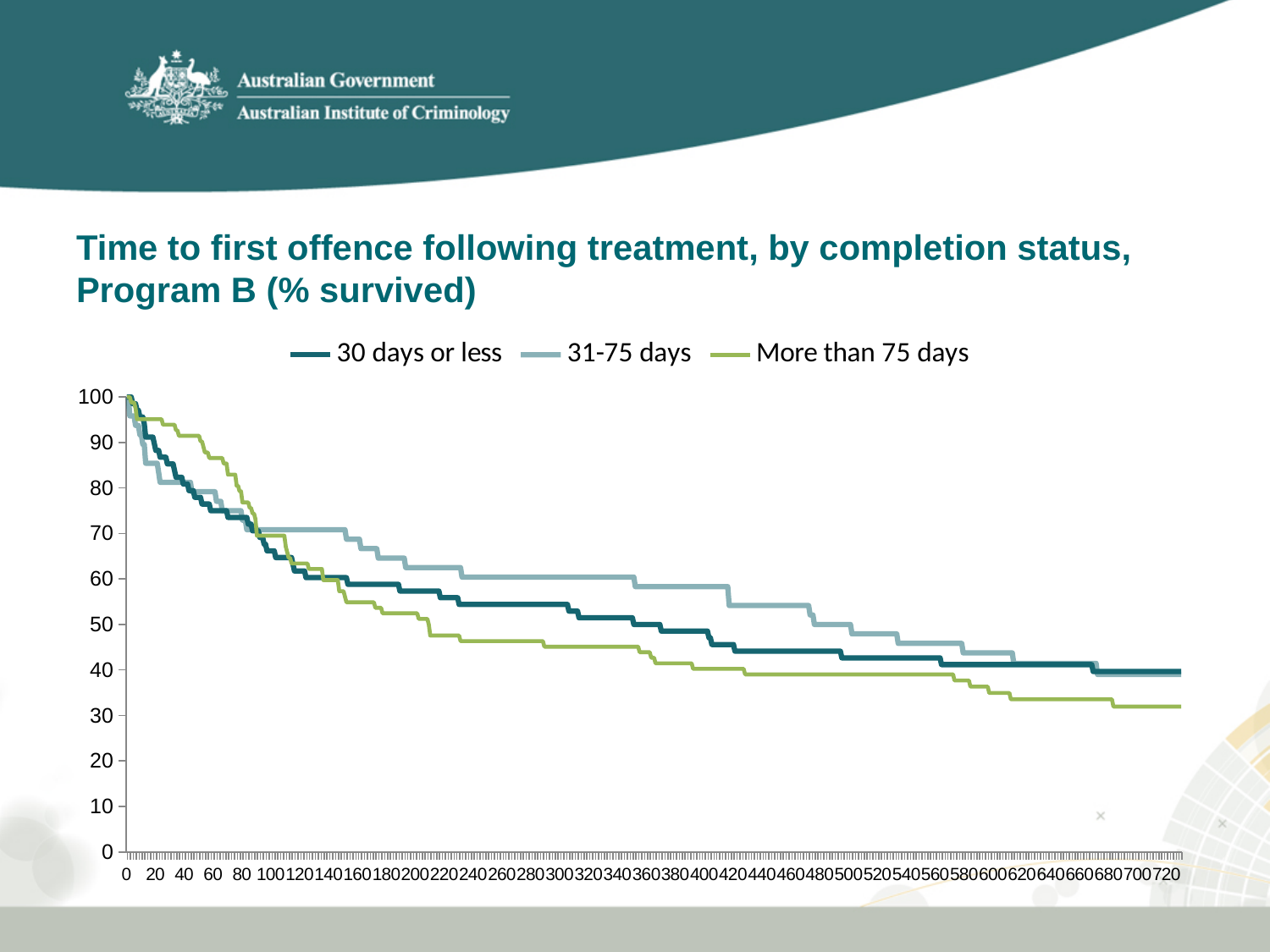
At what value do all three series start at x = 0? 100 Is the value for '31-75 days' at x = 300 greater or less than 50? greater What kind of chart is shown on the slide? line chart How many series does the legend list? 3 Which series has the highest value at x = 300? 31-75 days Do the values for the series rise or fall as you move along the x axis? fall Which three series are listed in the legend? 30 days or less, 31-75 days, More than 75 days At x = 300, which is larger: the value for '30 days or less' or the value for 'More than 75 days'? 30 days or less Is the value for '30 days or less' at x = 720 greater or less than 30? greater What is the title of the chart? Time to first offence following treatment, by completion status, Program B (% survived) Which series has the lowest value at the right end of the chart (x = 720)? More than 75 days Is the value for 'More than 75 days' at x = 720 greater or less than 40? less